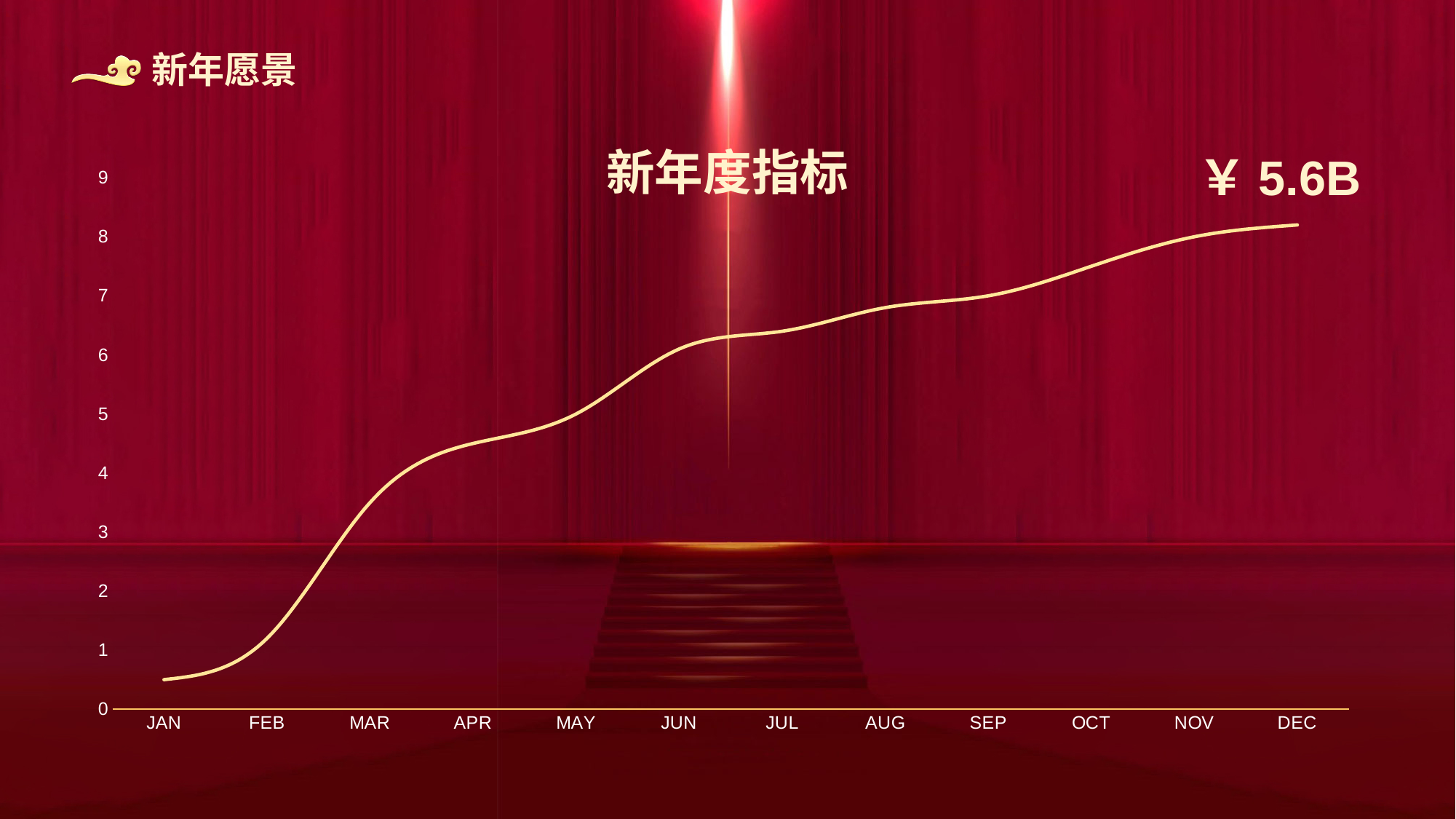
Is the value for NOV greater or less than 7? greater Which is larger, the value for MAR or the value for OCT? OCT How many months are plotted along the x axis? 12 Is the value for JUN greater or less than 5? greater Is the value for SEP greater or less than 8? less Which month has the lowest value on the line? JAN Which month has the highest value on the line? DEC What kind of chart is shown on the slide? line chart What is the title of the chart? 新年度指标 Do the values rise or fall from JAN to DEC? rise